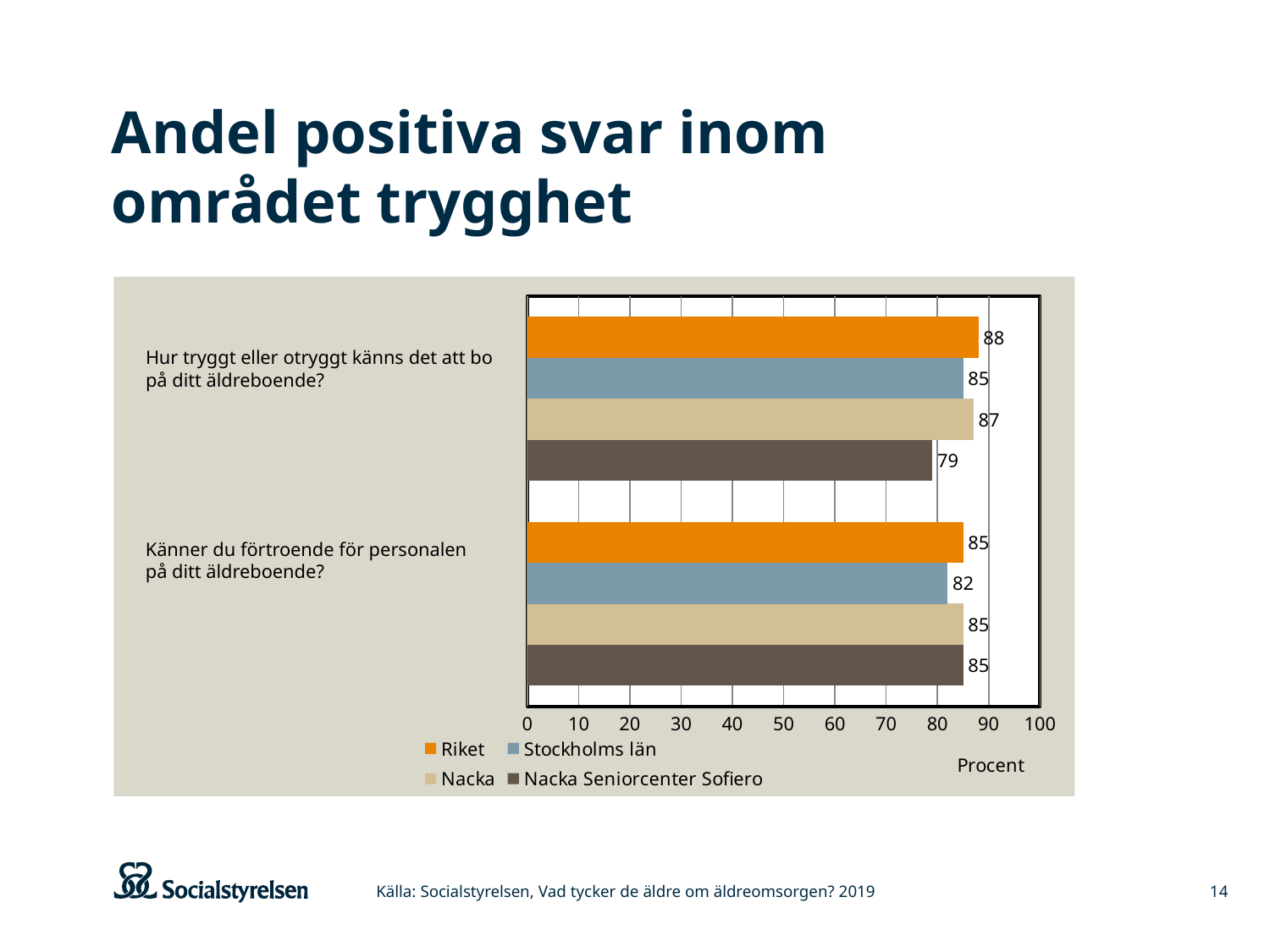
What is the value for Nacka Seniorcenter Sofiero on the question "Hur tryggt eller otryggt känns det att bo på ditt äldreboende?"? 79 Is the value for Nacka Seniorcenter Sofiero on the question "Hur tryggt eller otryggt känns det att bo på ditt äldreboende?" greater or less than 80? less What is the value for Riket on the question "Hur tryggt eller otryggt känns det att bo på ditt äldreboende?"? 88 On the question "Hur tryggt eller otryggt känns det att bo på ditt äldreboende?", which is larger: the value for Nacka or the value for Stockholms län? Nacka What kind of chart is shown on the slide? Bar chart Which series has the highest value on the question "Hur tryggt eller otryggt känns det att bo på ditt äldreboende?"? Riket How many series does the legend list? 4 What is the label on the horizontal axis of the chart? Procent What is the value for Stockholms län on the question "Känner du förtroende för personalen på ditt äldreboende?"? 82 Which series has the lowest value on the question "Känner du förtroende för personalen på ditt äldreboende?"? Stockholms län What is the value for Nacka on the question "Känner du förtroende för personalen på ditt äldreboende?"? 85 What is the difference between the Riket value and the Nacka Seniorcenter Sofiero value on the question "Hur tryggt eller otryggt känns det att bo på ditt äldreboende?"? 9